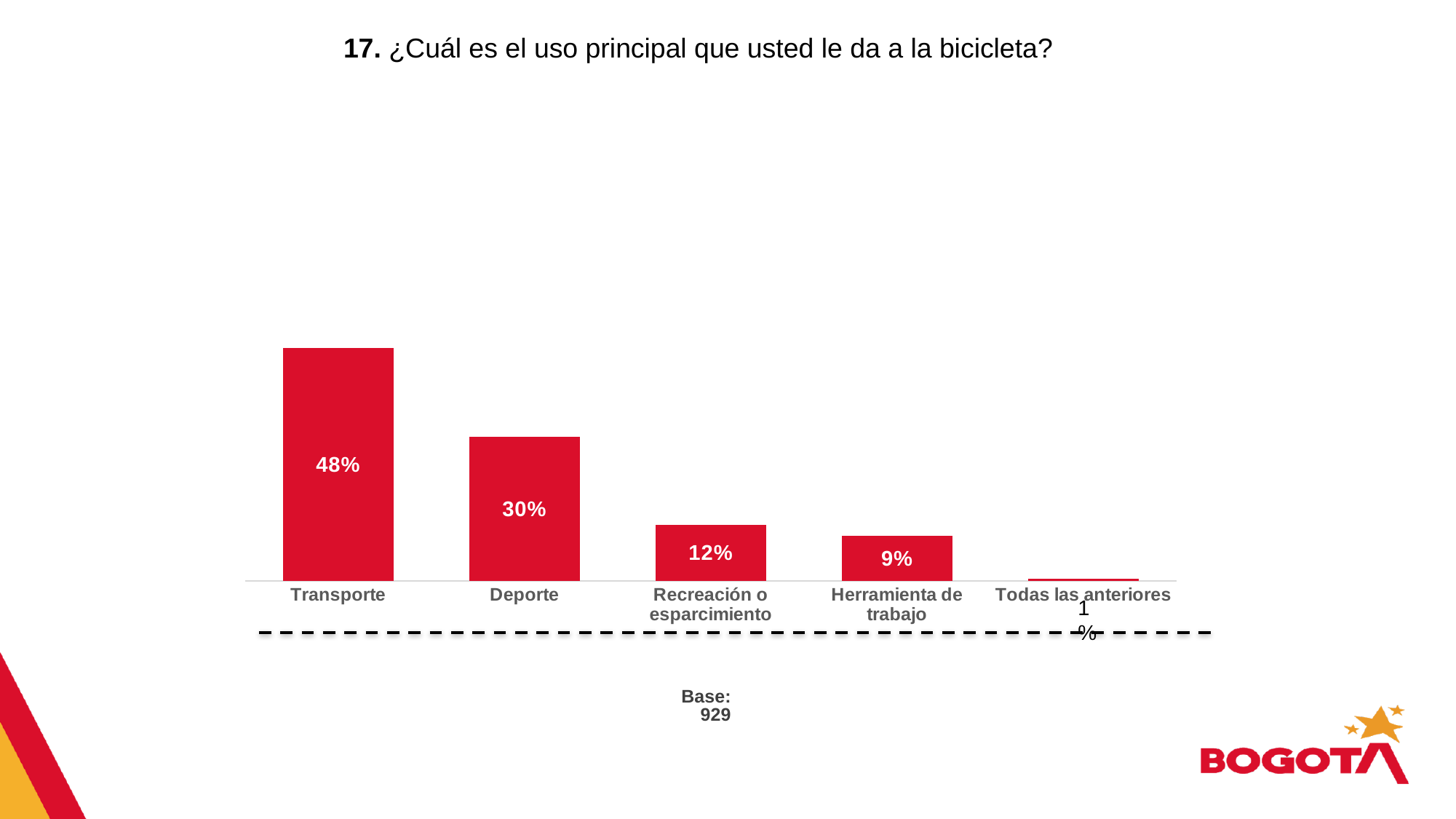
What is the base (number of respondents) shown below the chart? 929 What is the value for Recreación o esparcimiento? 12% Which category has the lowest value? Todas las anteriores Do the values rise or fall from left to right across the categories? Fall What is the difference between the values for Transporte and Deporte? 18% Which category has the highest value? Transporte What kind of chart is shown on the slide? Bar chart Which is larger, the value for Recreación o esparcimiento or the value for Herramienta de trabajo? Recreación o esparcimiento How many categories are shown in the chart? 5 What is the value for Deporte? 30% What is the value for Herramienta de trabajo? 9% What is the value for Transporte? 48%